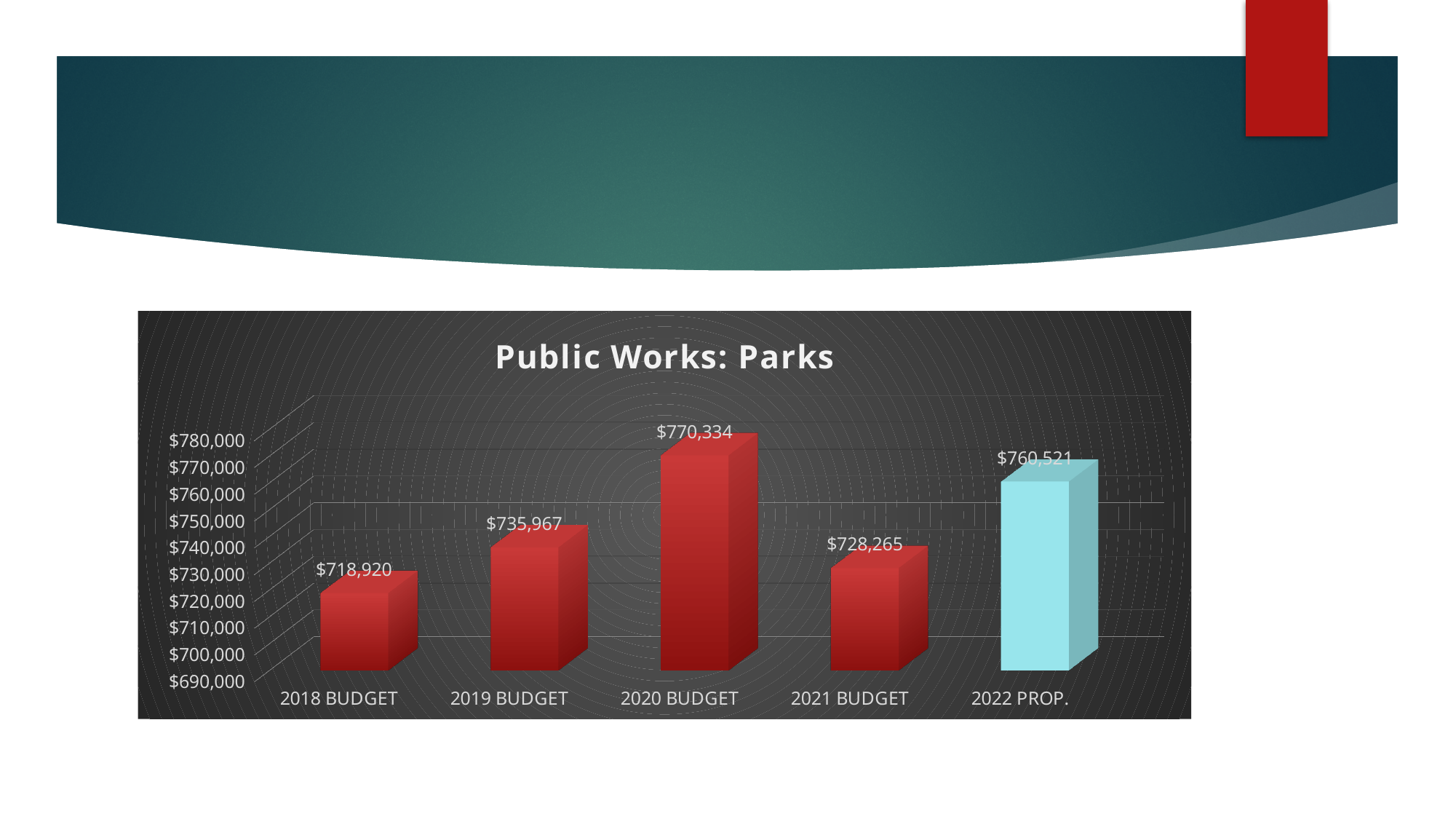
Is the value for 2020 BUDGET greater or less than $750,000? greater What is the value for 2020 BUDGET in the Public Works: Parks chart? $770,334 Which category has the highest value in the Public Works: Parks chart? 2020 BUDGET What is the value for 2022 PROP. in the Public Works: Parks chart? $760,521 What is the difference between the 2020 BUDGET and 2018 BUDGET values in the Public Works: Parks chart? $51,414 Which category has the lowest value in the Public Works: Parks chart? 2018 BUDGET How many categories are shown in the Public Works: Parks chart? 5 What is the value for 2018 BUDGET in the Public Works: Parks chart? $718,920 What is the value for 2021 BUDGET in the Public Works: Parks chart? $728,265 What is the difference between the 2022 PROP. and 2021 BUDGET values in the Public Works: Parks chart? $32,256 What kind of chart is shown on the slide? Bar chart Which is larger in the Public Works: Parks chart, 2019 BUDGET or 2021 BUDGET? 2019 BUDGET